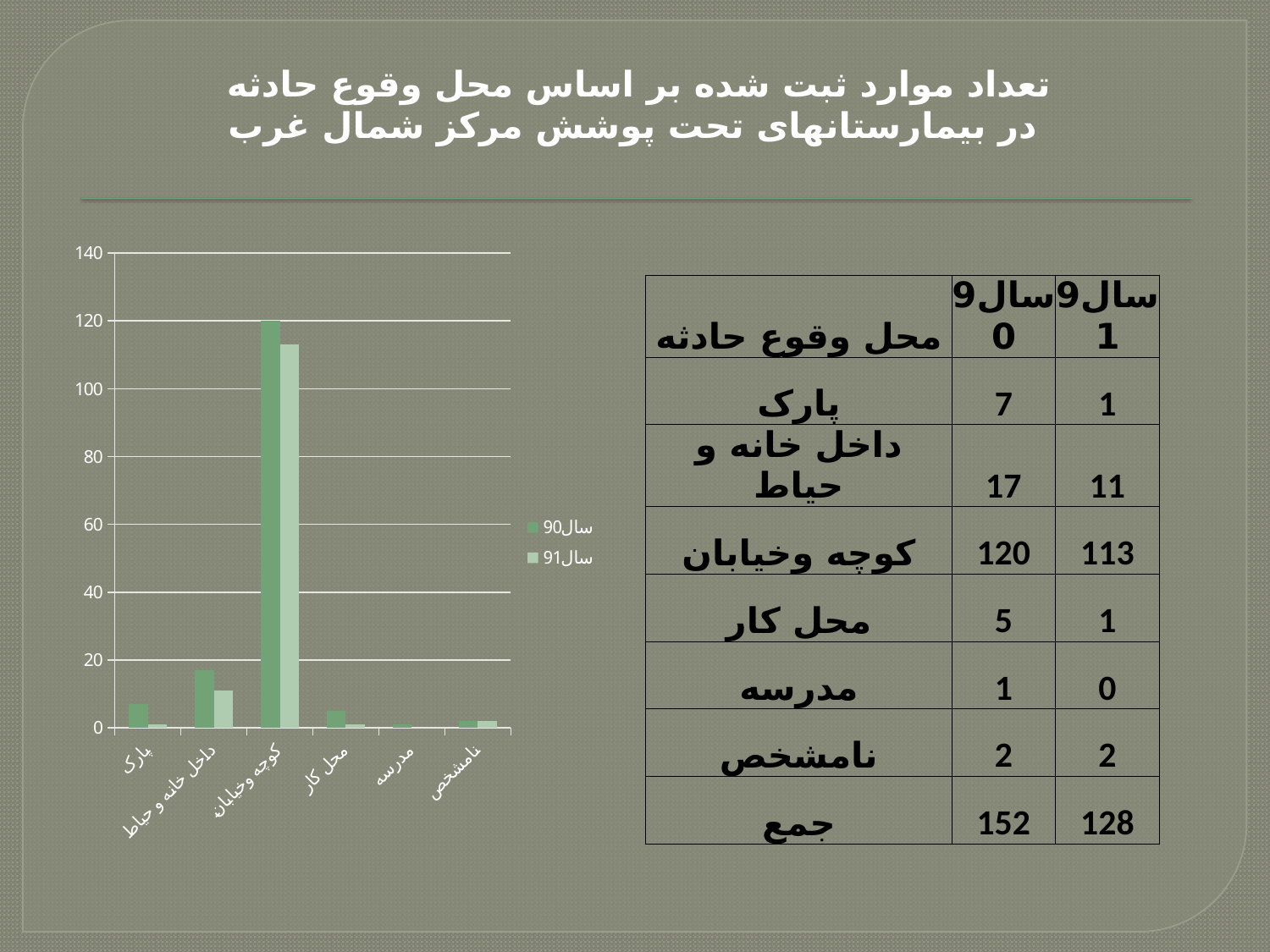
How many categories are shown on the x axis of the chart? 6 Is the value for کوچه وخیابان in سال91 greater or less than 100? greater Is the value for داخل خانه و حیاط in سال90 greater or less than 20? less How many series does the chart legend list? 2 For پارک, which series has the larger value, سال90 or سال91? سال90 What is the value for کوچه وخیابان in سال91? 113 What kind of chart is shown on the slide? bar chart Which category has the highest value for سال90? کوچه وخیابان What is the difference between the سال90 and سال91 values for کوچه وخیابان? 7 What is the value for داخل خانه و حیاط in سال90? 17 What is the value for کوچه وخیابان in سال90? 120 What are the two series names listed in the chart legend? سال90 and سال91